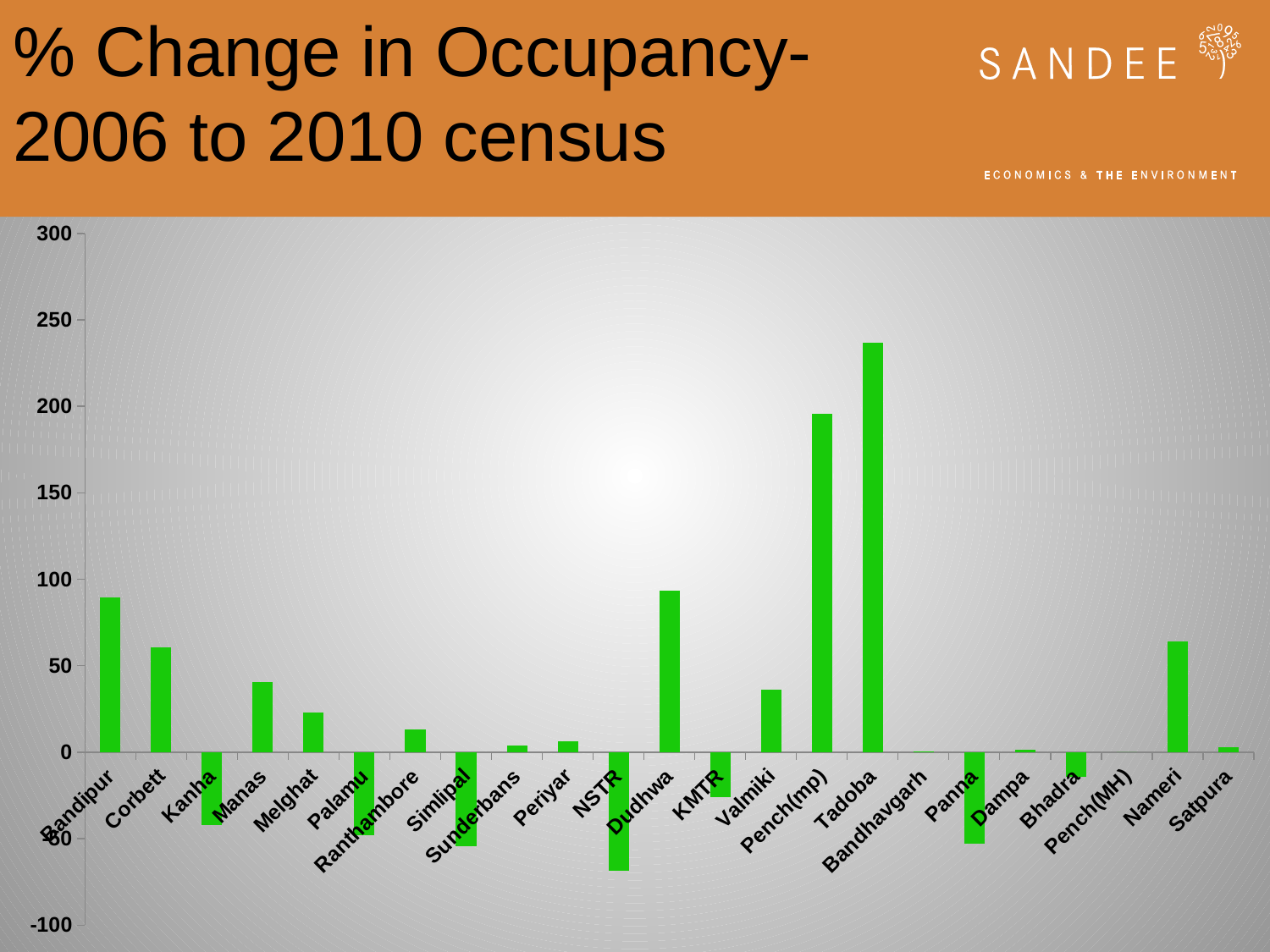
What is the title of the slide containing the chart? % Change in Occupancy- 2006 to 2010 census Which category has the lowest value in the chart? NSTR Is the value for Bandipur greater or less than 100? less What kind of chart is shown on the slide? bar chart Is the value for Tadoba greater or less than 200? greater Which is larger, the value for Tadoba or the value for Pench(mp)? Tadoba Is the value for Pench(mp) greater or less than 150? greater Which category has the highest value in the chart? Tadoba Which is larger, the value for Bandipur or the value for Corbett? Bandipur How many categories are plotted along the x axis? 23